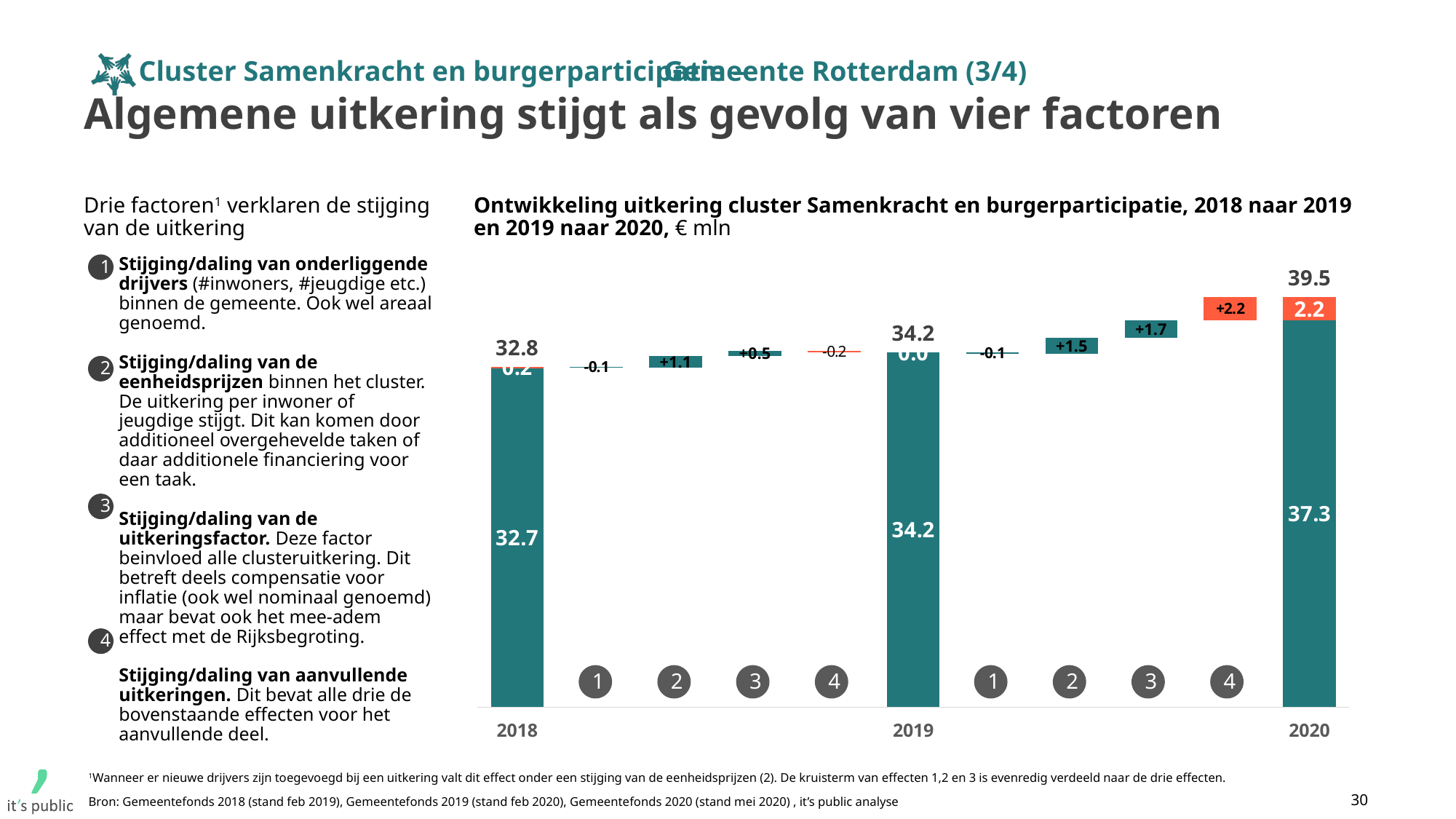
What is the value of factor 3 (uitkeringsfactor) in the step from 2019 to 2020? +1.7 What is the value of factor 2 (eenheidsprijzen) in the step from 2018 to 2019? +1.1 Which factor contributes more in the step from 2019 to 2020: factor 2 (+1.5) or factor 4 (+2.2)? Factor 4 (+2.2) What is the total uitkering value shown for 2019? 34.2 What is the value of the orange (upper) segment of the 2020 bar? 2.2 What is the value of factor 4 (aanvullende uitkeringen) in the step from 2018 to 2019? -0.2 What is the total uitkering value shown for 2020? 39.5 What is the total uitkering value shown for 2018? 32.8 Do the total uitkering values rise or fall from 2018 to 2020? Rise What is the value of the teal (lower) segment of the 2020 bar? 37.3 What is the difference between the 2020 total (39.5) and the 2018 total (32.8)? 6.7 Which year has the highest total uitkering value? 2020